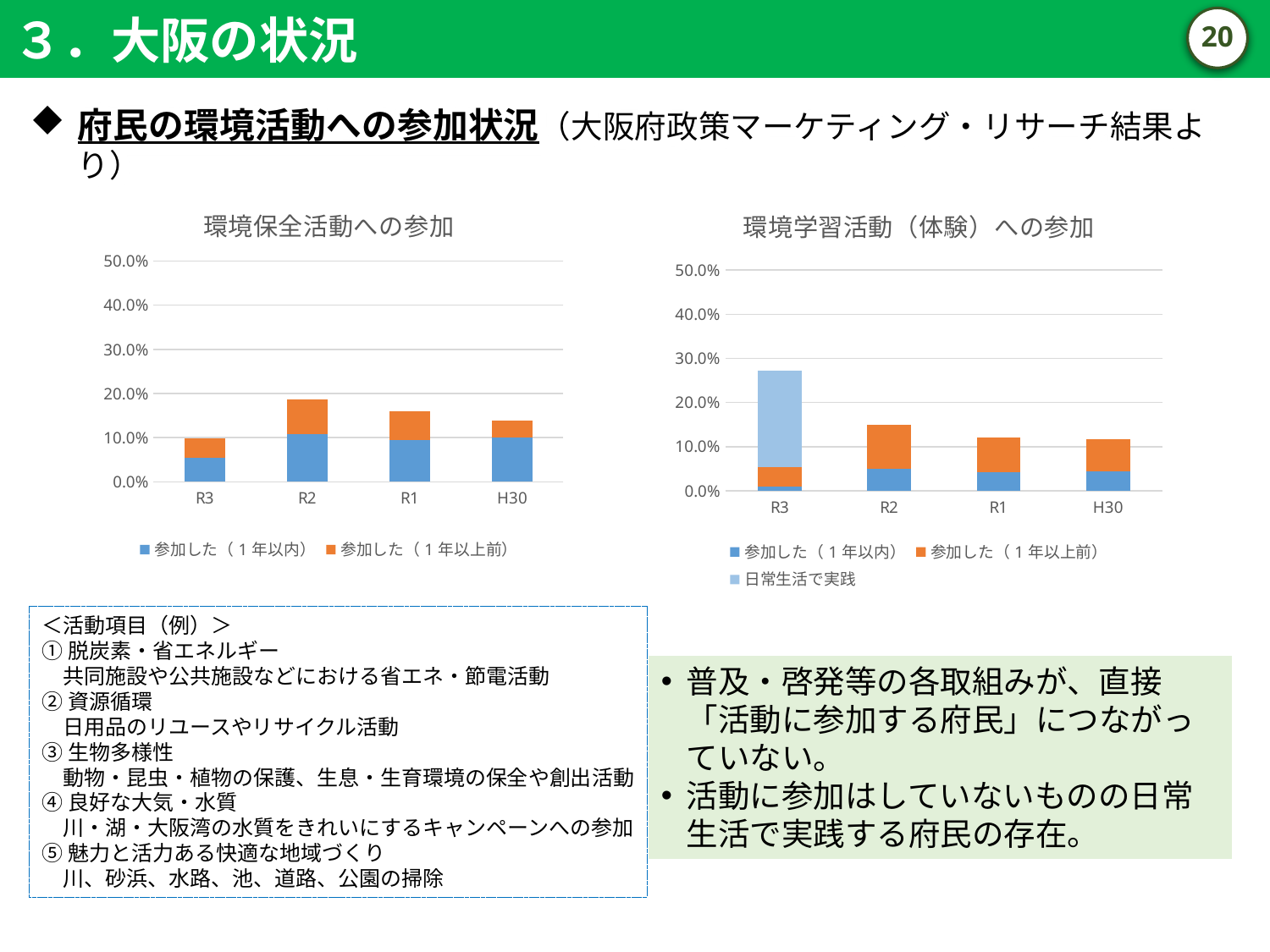
In the left chart (環境保全活動への参加), which category has the shortest stacked bar? R3 In the right chart (環境学習活動（体験）への参加), is the total stacked value for R2 greater or less than 20.0%? less In the right chart (環境学習活動（体験）への参加), which category has the tallest stacked bar? R3 How many series does the legend of the right chart (環境学習活動（体験）への参加) list? 3 How many series does the legend of the left chart (環境保全活動への参加) list? 2 In the left chart (環境保全活動への参加), which category has the tallest stacked bar? R2 Which series appears only in the legend of the right chart (環境学習活動（体験）への参加) and not in the left chart? 日常生活で実践 How many categories are shown on the x axis of the left chart (環境保全活動への参加)? 4 In the right chart (環境学習活動（体験）への参加), which has the larger total stacked bar, R3 or R2? R3 In the left chart (環境保全活動への参加), is the total stacked value for R2 greater or less than 10.0%? greater In the right chart (環境学習活動（体験）への参加), is the total stacked value for R3 greater or less than 20.0%? greater What kind of chart is the left chart titled 環境保全活動への参加? Stacked bar chart